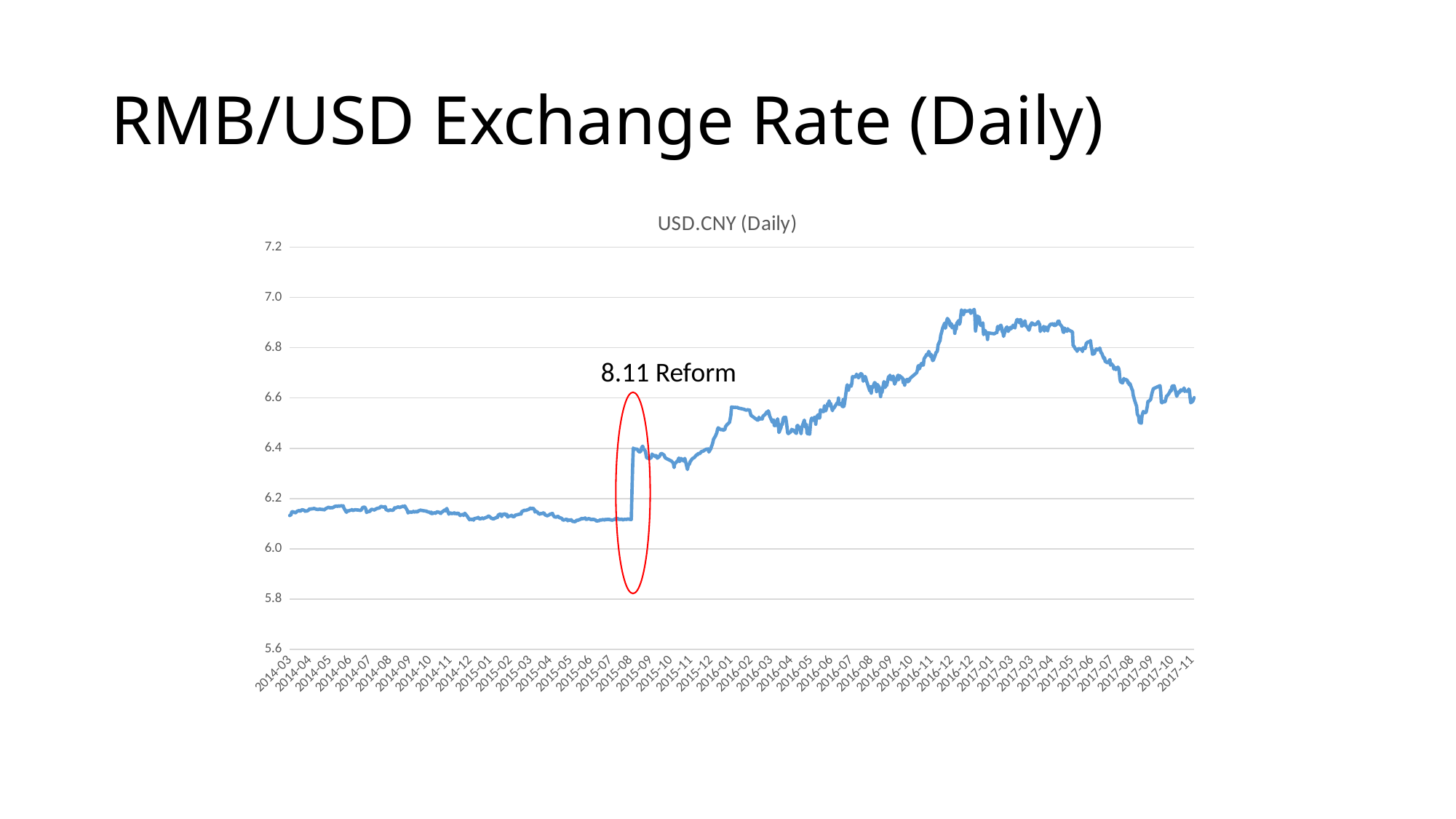
What is the title of the chart? USD.CNY (Daily) Does the exchange rate rise or fall between 2015-08 and 2016-12? rise What kind of chart is shown on the slide? line chart Does the exchange rate rise or fall between 2017-01 and 2017-11? fall How many data series are plotted on the chart? 1 What event is annotated with a red ellipse on the chart? 8.11 Reform Is the value at 2016-12 greater or less than 6.8? greater Is the value at 2017-11 greater or less than 6.8? less Is the value at 2014-03 greater or less than 6.2? less